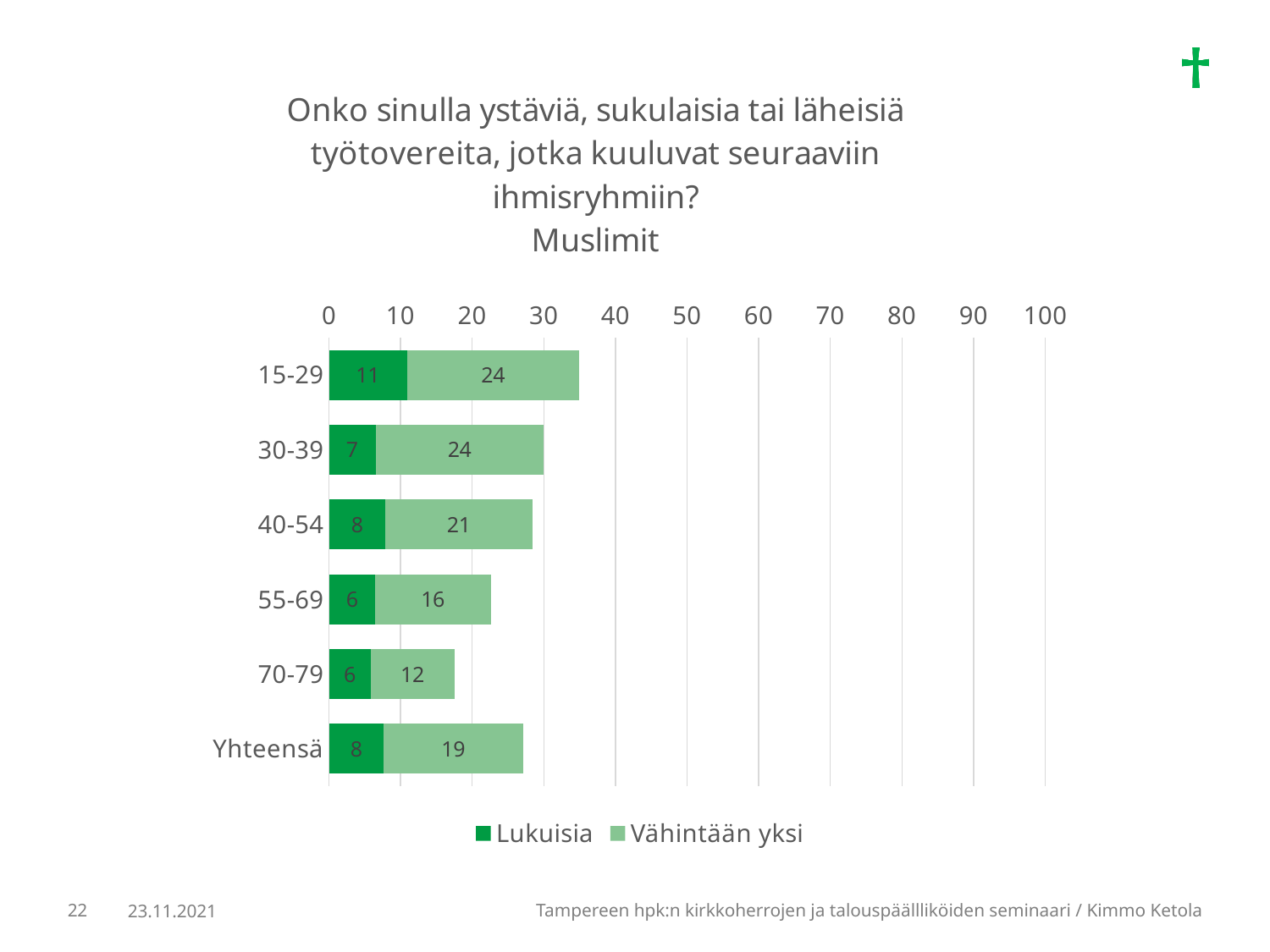
How many series does the legend list? 2 What is the total of the stacked bar for the 15-29 age group? 35 What is the value of Vähintään yksi for Yhteensä? 19 What kind of chart is shown on the slide? Stacked bar chart Which category has the lowest Vähintään yksi value? 70-79 Which is larger, the Lukuisia value for 30-39 or for 40-54? 40-54 How many categories are shown on the y axis? 6 What is the difference between the Vähintään yksi values for 15-29 and 70-79? 12 What is the total of the stacked bar for the 70-79 age group? 18 What is the value of Lukuisia for the 15-29 age group? 11 Which age group has the highest Lukuisia value? 15-29 What is the value of Vähintään yksi for the 55-69 age group? 16